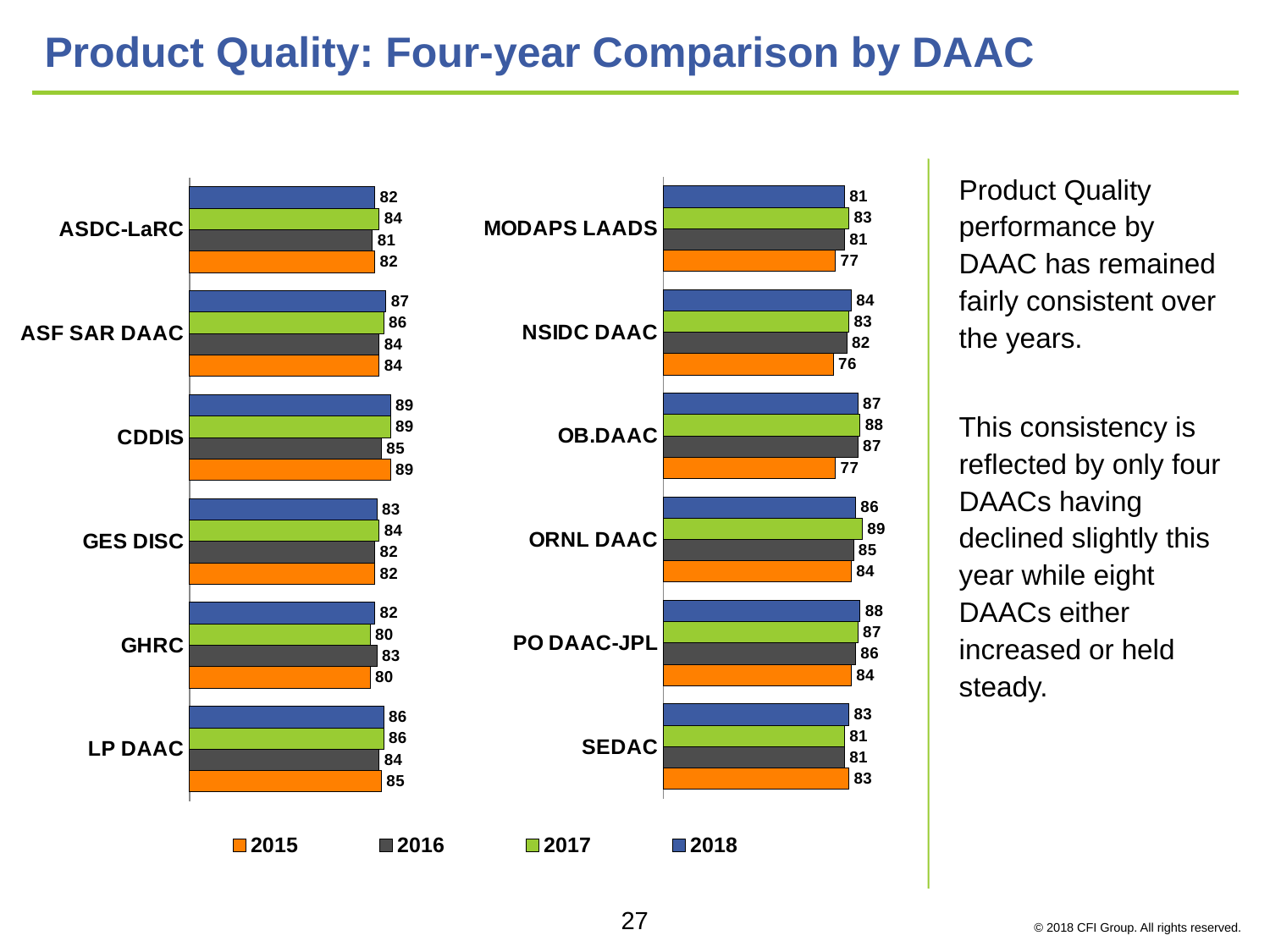
What type of chart is used on this slide? bar chart On the right chart, which DAAC has the highest 2017 value? ORNL DAAC On the right chart, what is the 2015 value for NSIDC DAAC? 76 On the right chart, what is the 2017 value for PO DAAC-JPL? 87 On the right chart, which is larger for SEDAC: the 2017 value or the 2015 value? 2015 On the left chart, what is the 2018 value for CDDIS? 89 On the left chart, which DAAC has the lowest 2015 value? GHRC On the left chart, is the 2018 value for ASF SAR DAAC larger or smaller than the 2018 value for LP DAAC? larger How many DAACs are shown on the left chart? 6 On the right chart, what is the difference between the 2018 and 2015 values for OB.DAAC? 10 How many series does the legend list? 4 On the left chart, what is the 2016 value for GHRC? 83